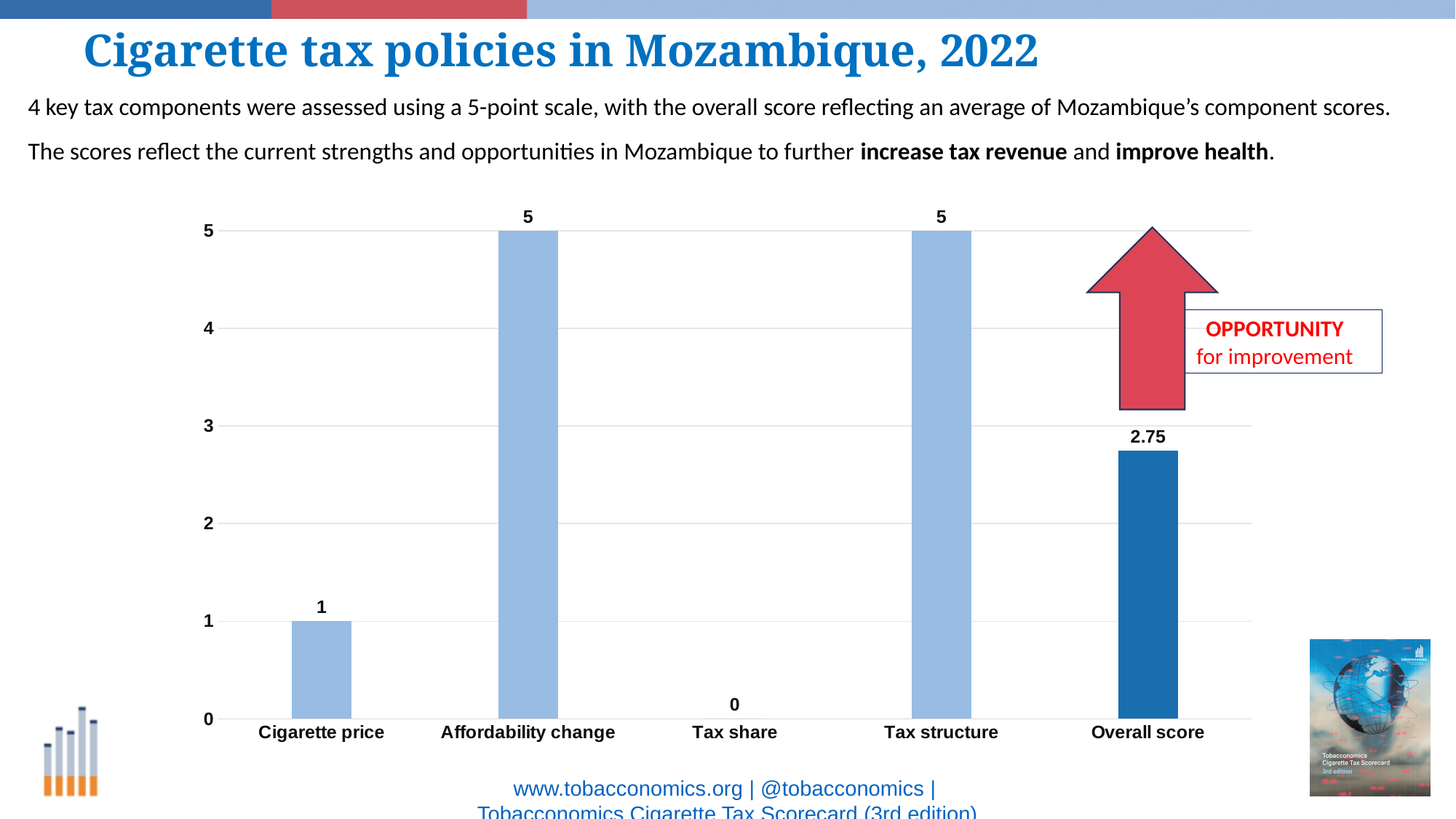
Is the value for Overall score greater or less than 3? less What is the difference between the Affordability change value and the Overall score? 2.25 What kind of chart is shown on the slide? bar chart What text appears in the box next to the red arrow above the Overall score bar? OPPORTUNITY for improvement What is the Overall score shown on the chart? 2.75 Which is larger, the value for Cigarette price or the Overall score? Overall score What is the difference between the Tax structure value and the Cigarette price value? 4 How many categories are shown on the x axis? 5 Which category has the lowest value? Tax share What is the value for Tax share? 0 What is the value for Cigarette price? 1 What is the value for Affordability change? 5